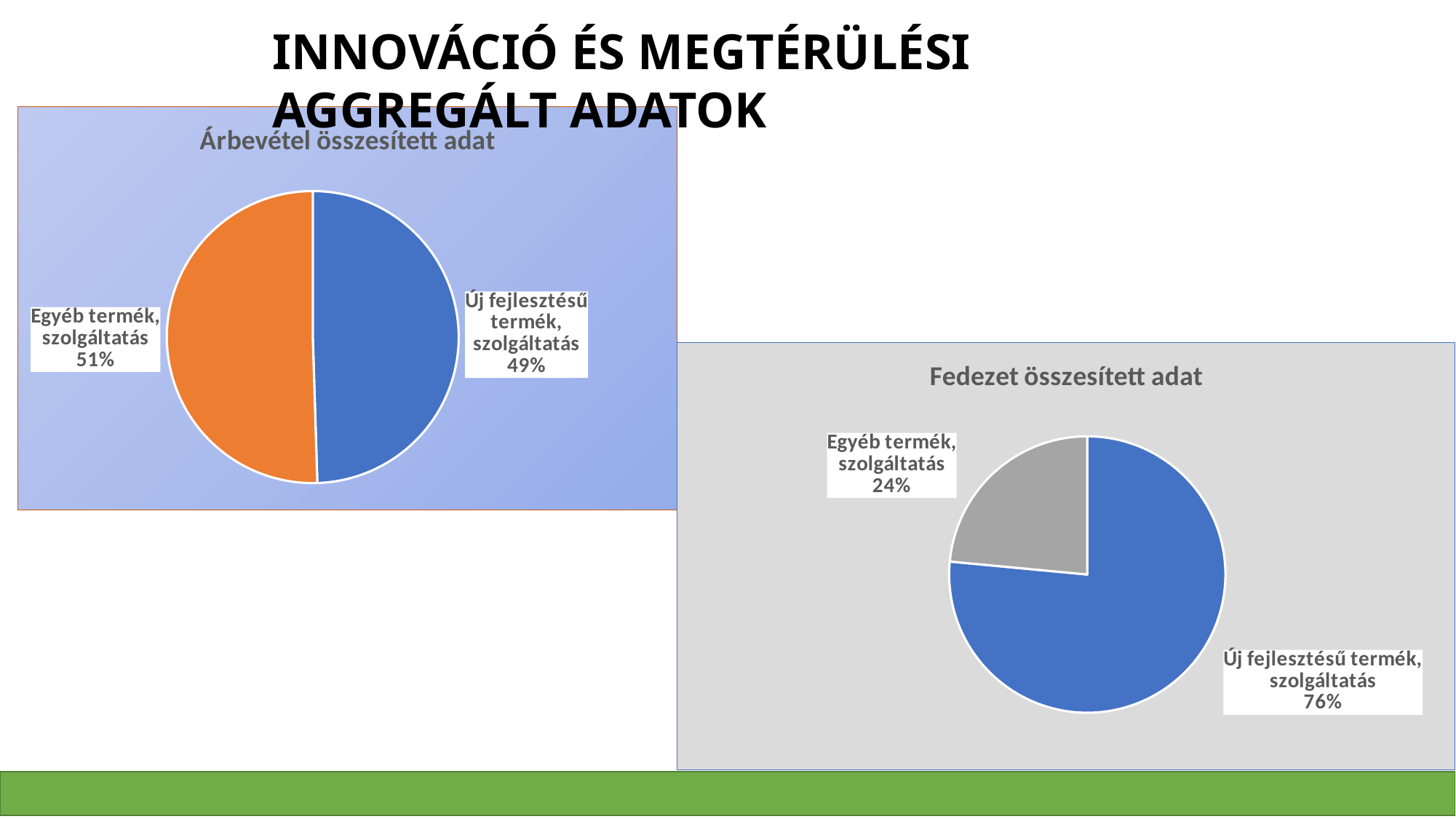
How many slices does the 'Fedezet összesített adat' chart have? 2 In the 'Árbevétel összesített adat' chart, what share does 'Új fejlesztésű termék, szolgáltatás' have? 49% In the 'Árbevétel összesített adat' chart, what share does 'Egyéb termék, szolgáltatás' have? 51% What is the title of the chart on the right side of the slide? Fedezet összesített adat In the 'Fedezet összesített adat' chart, what share does 'Egyéb termék, szolgáltatás' have? 24% In the 'Fedezet összesített adat' chart, what is the difference in percentage points between the two slices? 52 What kind of chart is 'Árbevétel összesített adat'? Pie chart In the 'Fedezet összesített adat' chart, which slice is the smallest? Egyéb termék, szolgáltatás In the 'Fedezet összesített adat' chart, which slice is the largest? Új fejlesztésű termék, szolgáltatás How many charts are shown on the slide? 2 In the 'Árbevétel összesített adat' chart, what is the difference in percentage points between the two slices? 2